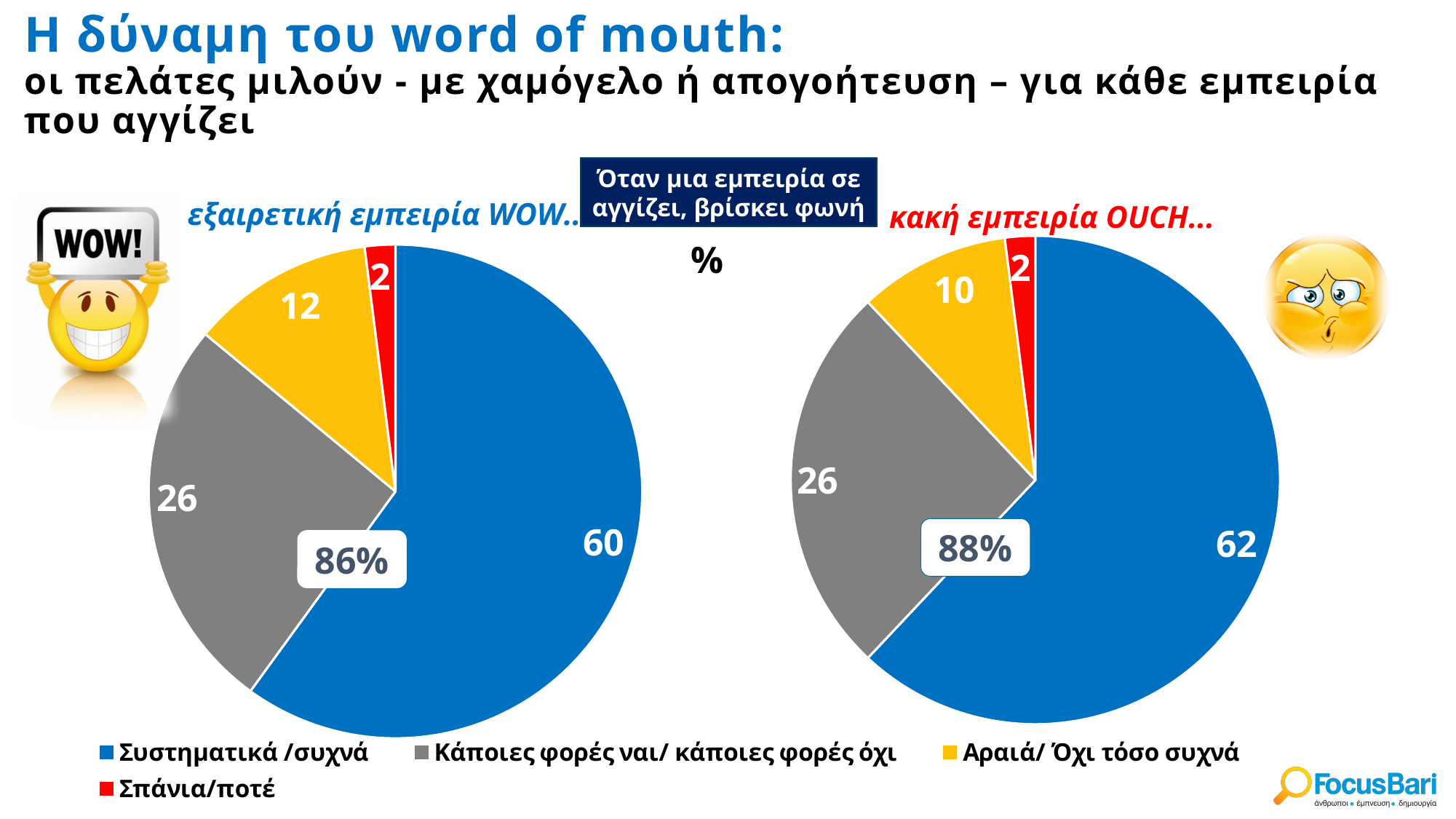
Which is larger: the Συστηματικά /συχνά value in the left pie chart (WOW) or in the right pie chart (OUCH)? Right pie chart (OUCH), 62 What type of chart is used on this slide? Pie chart In the right pie chart (κακή εμπειρία OUCH...), what is the value for Αραιά/ Όχι τόσο συχνά? 10 What percentage is shown in the callout box on the right pie chart (κακή εμπειρία OUCH...)? 88% In the left pie chart (εξαιρετική εμπειρία WOW...), what is the difference between the values for Συστηματικά /συχνά and Κάποιες φορές ναι/ κάποιες φορές όχι? 34 In the left pie chart (εξαιρετική εμπειρία WOW...), what is the value for Συστηματικά /συχνά? 60 In the left pie chart (εξαιρετική εμπειρία WOW...), which category has the largest slice? Συστηματικά /συχνά In the right pie chart (κακή εμπειρία OUCH...), which category has the smallest slice? Σπάνια/ποτέ How many slices does the right pie chart (κακή εμπειρία OUCH...) have? 4 How many series does the legend list? 4 In the left pie chart (εξαιρετική εμπειρία WOW...), what is the value for Αραιά/ Όχι τόσο συχνά? 12 In the right pie chart (κακή εμπειρία OUCH...), what is the value for Συστηματικά /συχνά? 62